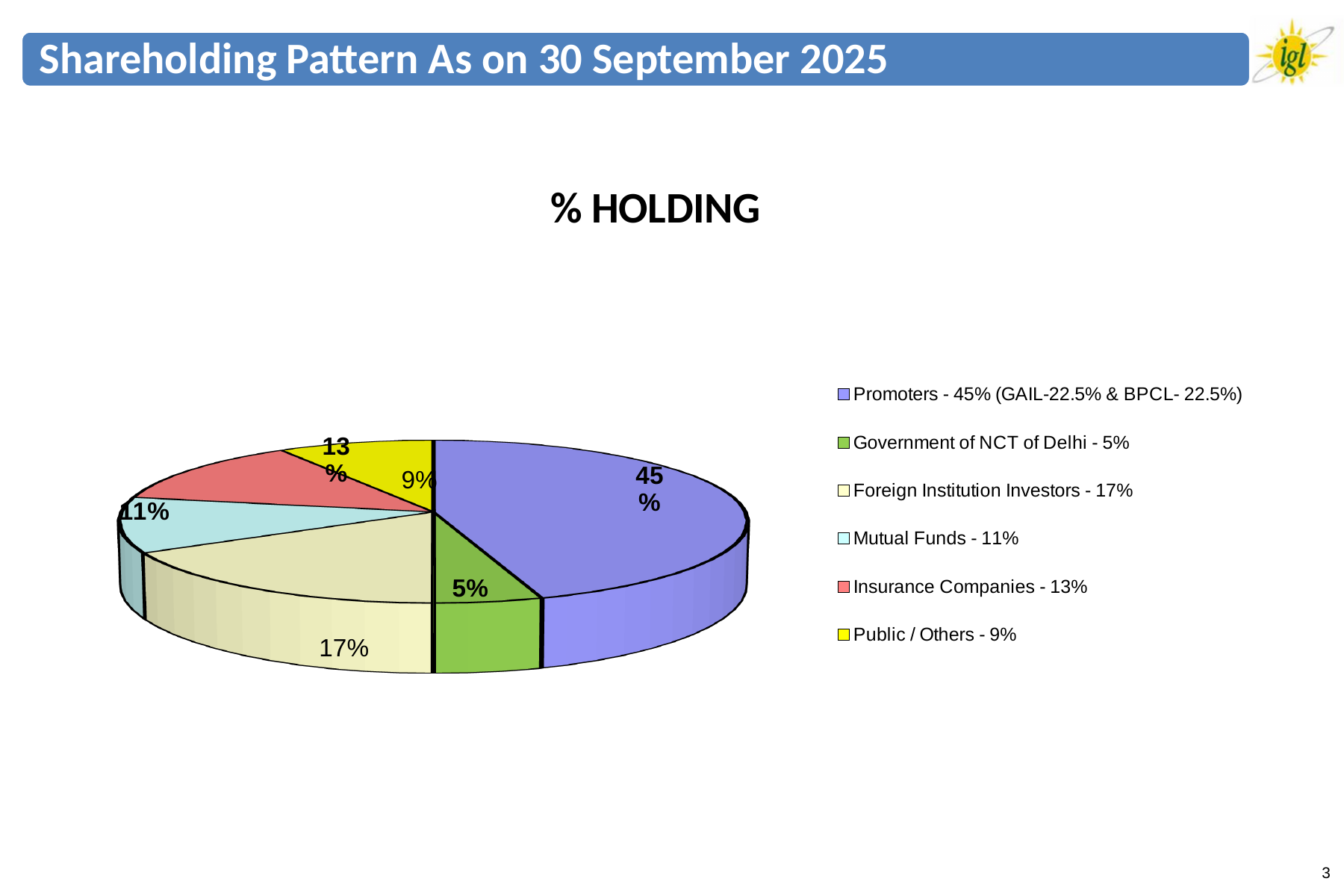
What is the difference between the Insurance Companies share and the Public / Others share? 4% What kind of chart is shown on the slide? Pie chart What colour is the Public / Others slice? Yellow What is the chart's title? % HOLDING How many categories does the pie chart show? 6 What share of holding does the Government of NCT of Delhi have? 5% What share of holding do Mutual Funds have? 11% Which is larger, the share for Mutual Funds or the share for Insurance Companies? Insurance Companies Which category has the smallest share of holding? Government of NCT of Delhi Which category has the largest share of holding? Promoters What share of holding do Foreign Institution Investors have? 17% What share of holding do Promoters have? 45%